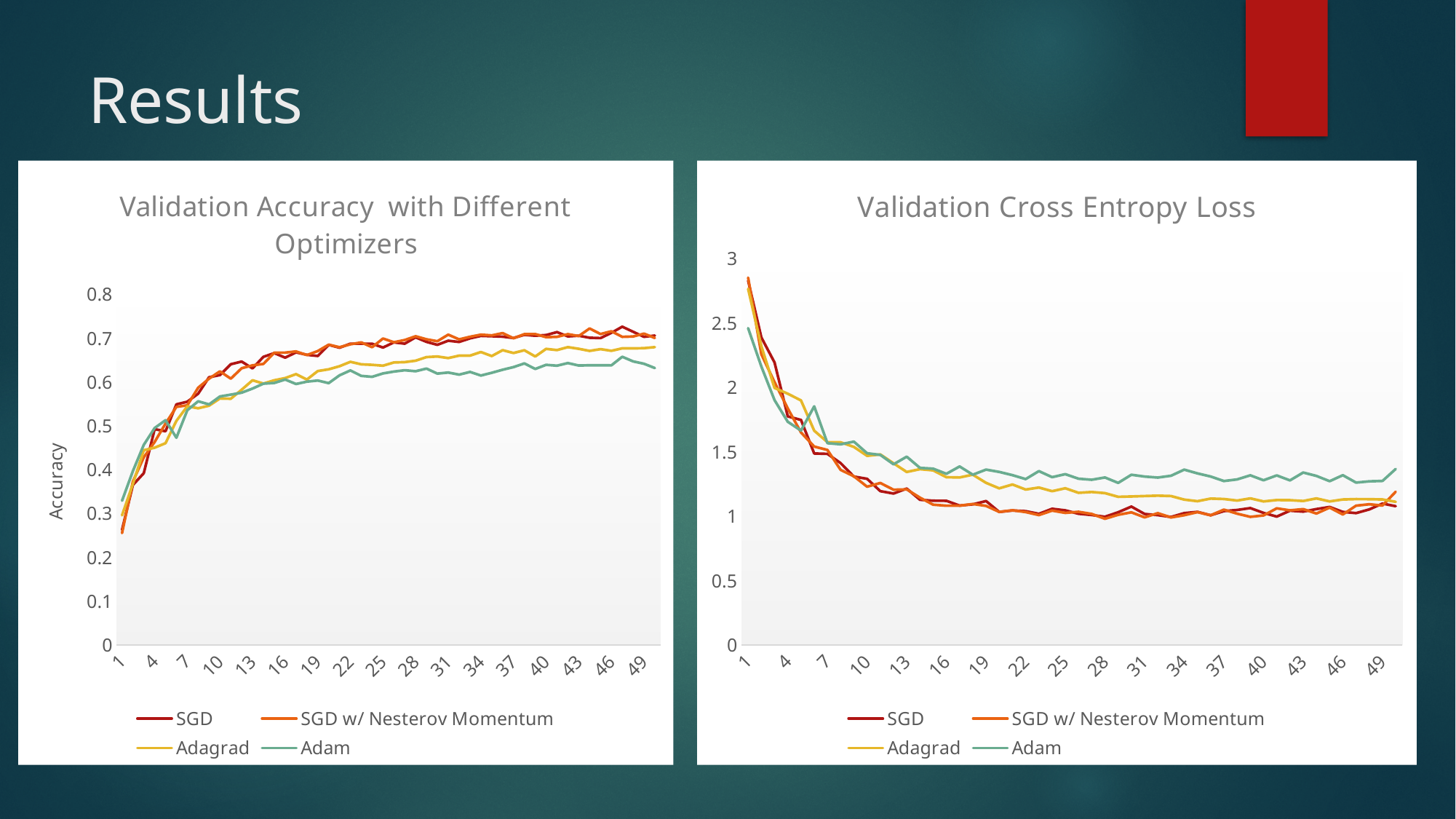
What kind of chart is the 'Validation Accuracy with Different Optimizers' chart? line chart In the 'Validation Accuracy with Different Optimizers' chart, do the values generally rise or fall along the x axis? rise In the 'Validation Accuracy with Different Optimizers' chart, is the Adam value at epoch 49 greater or less than 0.7? less In the 'Validation Cross Entropy Loss' chart, is the Adam value at epoch 49 greater or less than 1? greater How many series does the legend of the 'Validation Cross Entropy Loss' chart list? 4 In the 'Validation Cross Entropy Loss' chart, is the SGD value at epoch 1 greater or less than 2.5? greater How many series does the legend of the 'Validation Accuracy with Different Optimizers' chart list? 4 What is the label on the vertical axis of the 'Validation Accuracy with Different Optimizers' chart? Accuracy In the 'Validation Cross Entropy Loss' chart, do the values generally rise or fall along the x axis? fall What kind of chart is the 'Validation Cross Entropy Loss' chart? line chart In the 'Validation Cross Entropy Loss' chart, which series has the higher value at epoch 49, Adam or SGD? Adam